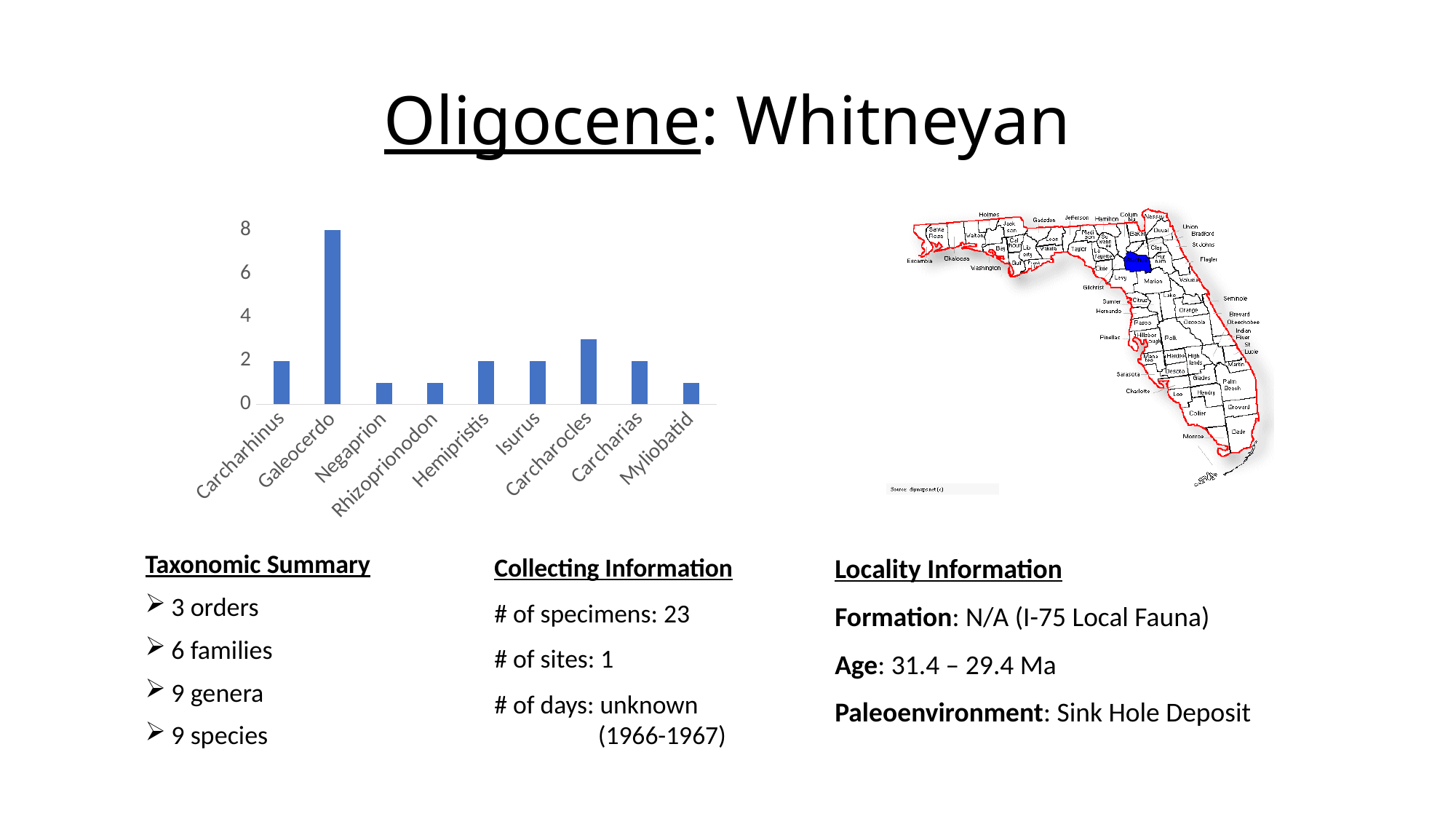
Which is larger, the value for Galeocerdo or the value for Carcharocles? Galeocerdo What is the value for Isurus in the bar chart? 2 How many categories are shown on the x axis of the bar chart? 9 Which is larger, the value for Carcharocles or the value for Isurus? Carcharocles Is the value for Carcharocles greater or less than 2? greater Is the value for Negaprion greater or less than 2? less What kind of chart is shown on the slide? bar chart What is the value for Carcharhinus in the bar chart? 2 What is the value for Galeocerdo in the bar chart? 8 What is the highest tick value shown on the y axis of the bar chart? 8 Which category has the highest value in the bar chart? Galeocerdo What is the difference between the values for Galeocerdo and Carcharhinus? 6